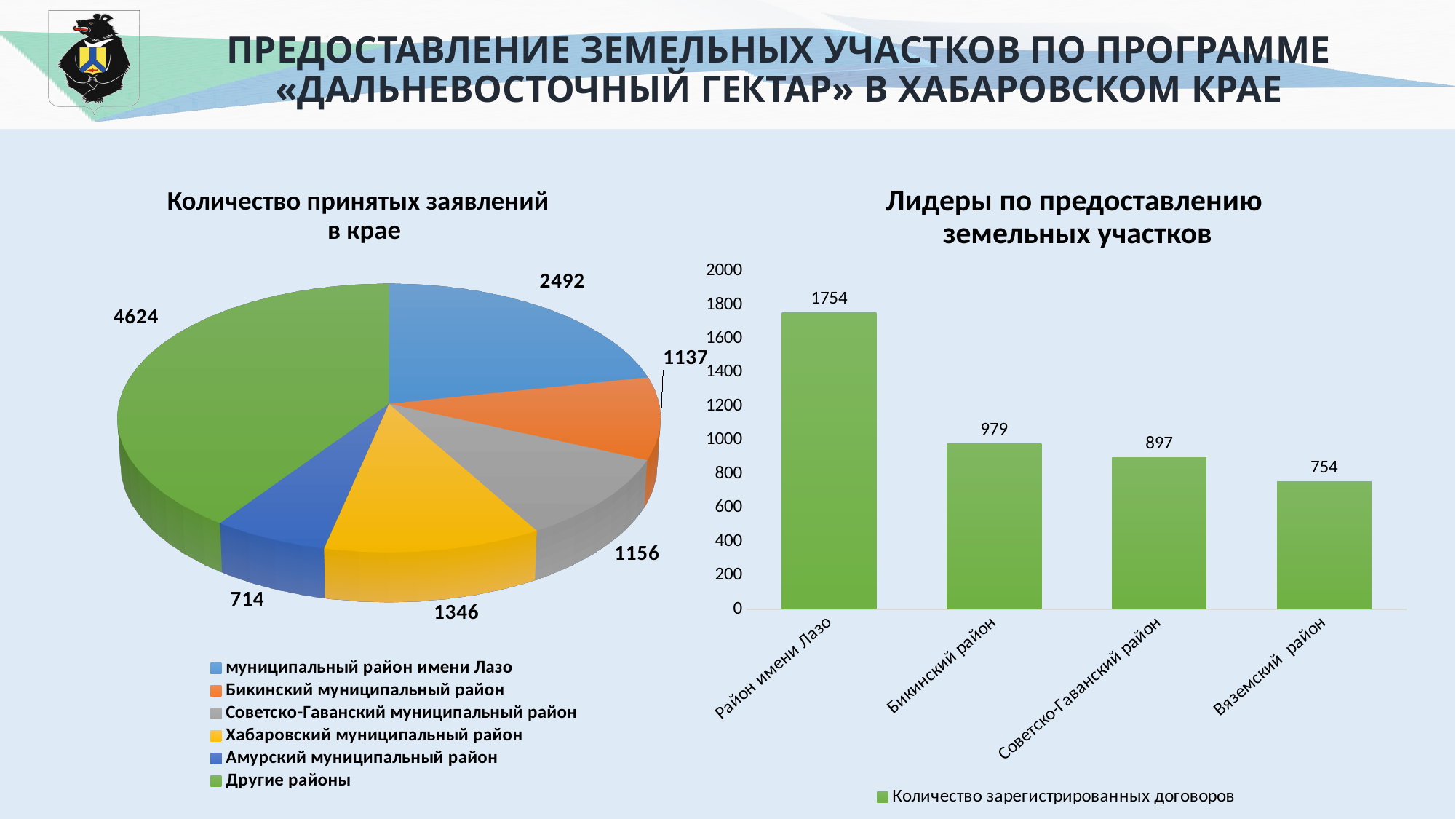
In the pie chart 'Количество принятых заявлений в крае', what is the value for Хабаровский муниципальный район? 1346 In the pie chart 'Количество принятых заявлений в крае', how many categories does the legend list? 6 In the chart 'Лидеры по предоставлению земельных участков', what is the value for Бикинский район? 979 In the pie chart 'Количество принятых заявлений в крае', which is larger: Бикинский муниципальный район or Амурский муниципальный район? Бикинский муниципальный район In the chart 'Лидеры по предоставлению земельных участков', how many districts are shown? 4 What type of chart is 'Лидеры по предоставлению земельных участков'? Bar chart In the chart 'Лидеры по предоставлению земельных участков', which district has the lowest value? Вяземский район In the chart 'Лидеры по предоставлению земельных участков', which district has the highest value? Район имени Лазо In the chart 'Лидеры по предоставлению земельных участков', what is the difference between Район имени Лазо and Бикинский район? 775 In the pie chart 'Количество принятых заявлений в крае', what colour is the slice for Советско-Гаванский муниципальный район? Gray In the pie chart 'Количество принятых заявлений в крае', which category has the largest slice? Другие районы In the chart 'Лидеры по предоставлению земельных участков', do the values rise or fall from left to right? Fall